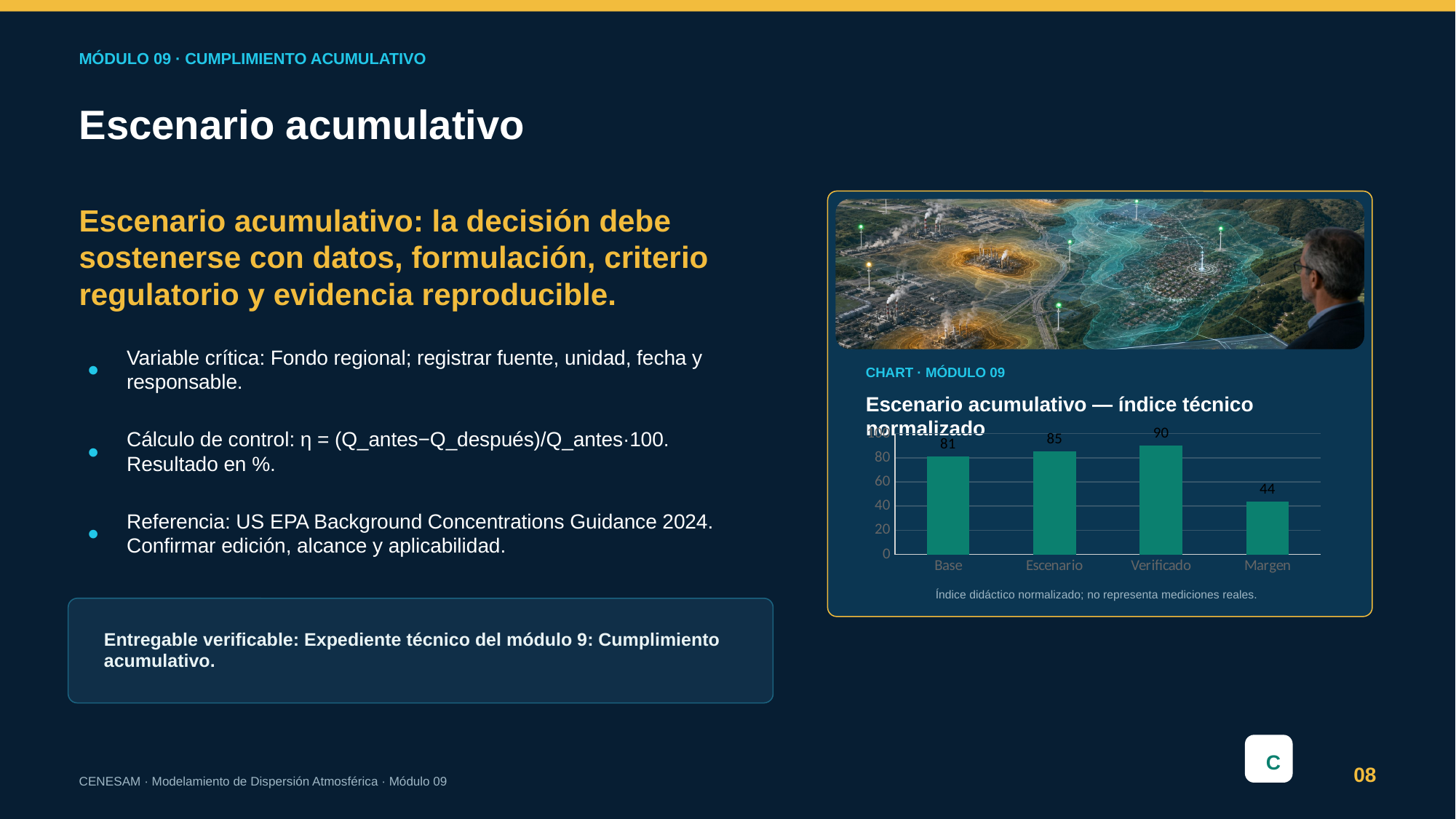
What is the value for Margen? 44 What is the difference between the values for Escenario and Base? 4 Which is larger, the value for Base or the value for Margen? Base What kind of chart is shown? Bar chart What is the difference between the values for Verificado and Margen? 46 What is the value for Verificado? 90 How many categories are shown on the x axis? 4 Which category has the lowest value? Margen What is the value for Escenario? 85 What is the value for Base? 81 What is the title of the chart? Escenario acumulativo — índice técnico normalizado Which category has the highest value? Verificado